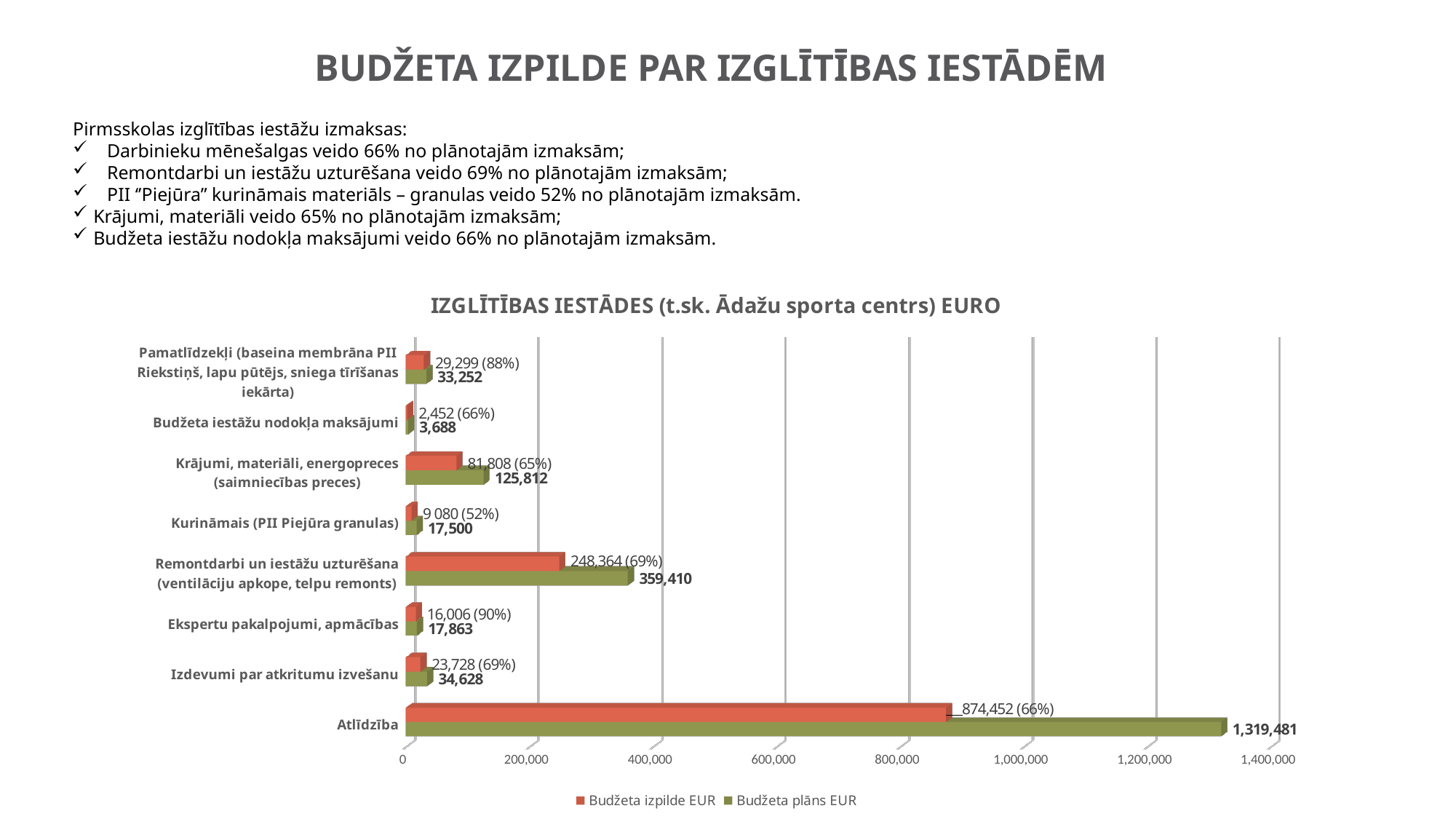
What percentage of the plan is shown next to the Budžeta izpilde bar for Kurināmais (PII Piejūra granulas)? 52% Which category has the lowest Budžeta plāns EUR value? Budžeta iestāžu nodokļa maksājumi How many series does the legend list? 2 What is the Budžeta izpilde EUR value for Remontdarbi un iestāžu uzturēšana (ventilāciju apkope, telpu remonts)? 248,364 How many categories are shown on the chart? 8 What is the difference between the Budžeta plāns EUR and Budžeta izpilde EUR values for Remontdarbi un iestāžu uzturēšana? 111,046 Which is larger: the Budžeta plāns EUR value for Izdevumi par atkritumu izvešanu or for Pamatlīdzekļi (baseina membrāna PII Riekstiņš, lapu pūtējs, sniega tīrīšanas iekārta)? Izdevumi par atkritumu izvešanu What is the Budžeta plāns EUR value for Krājumi, materiāli, energopreces (saimniecības preces)? 125,812 What is the Budžeta plāns EUR value for Atlīdzība? 1,319,481 Which category has the highest Budžeta plāns EUR value? Atlīdzība What is the difference between the Budžeta plāns EUR and Budžeta izpilde EUR values for Atlīdzība? 445,029 What kind of chart is shown on the slide? Bar chart